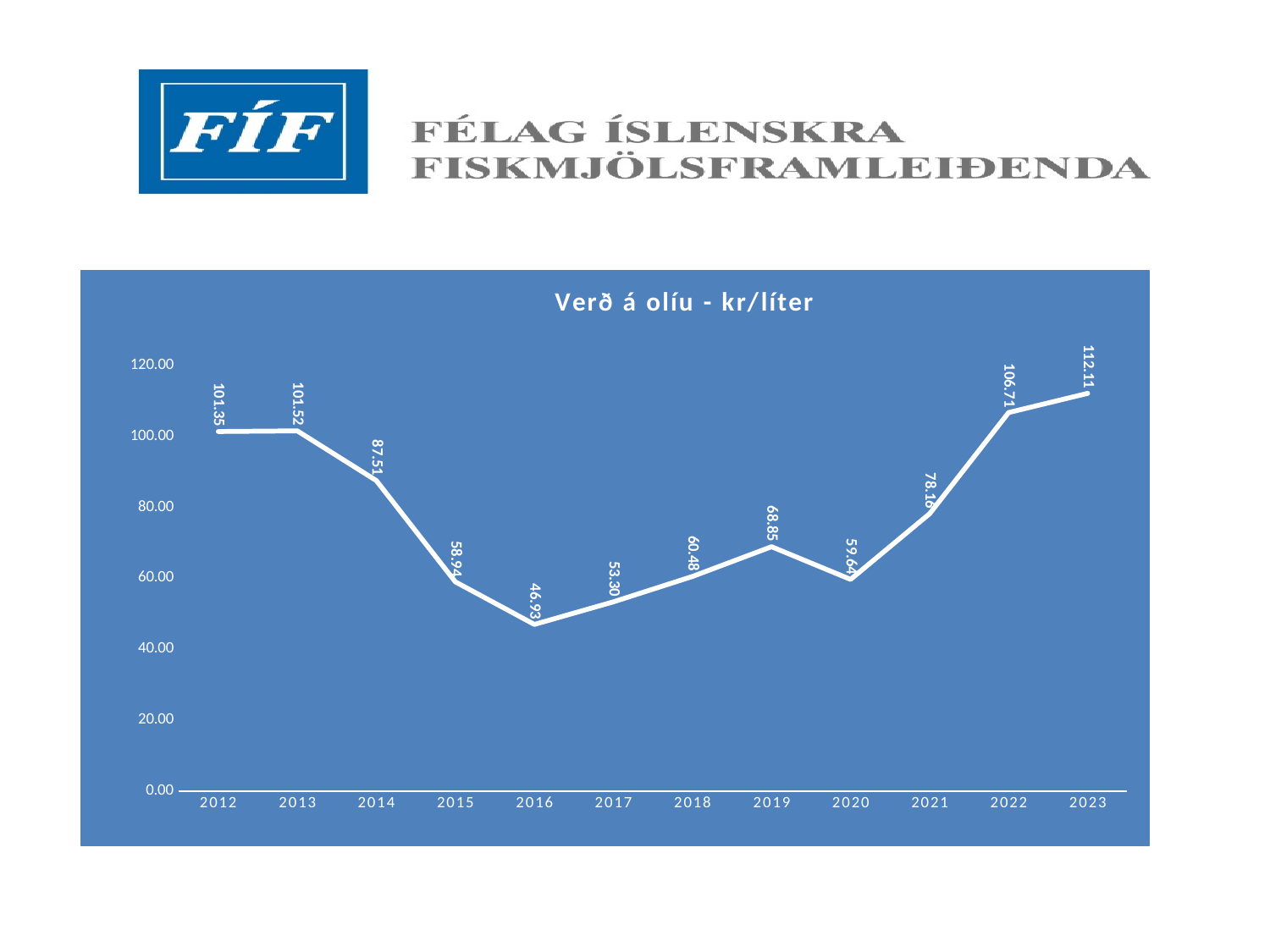
What kind of chart is shown on the slide? line chart What is the difference between the values for 2023 and 2022? 5.40 What is the value for 2023? 112.11 Which year has the lowest value? 2016 What is the title of the chart? Verð á olíu - kr/líter What is the value for 2016? 46.93 What is the value for 2012? 101.35 Which year has the highest value? 2023 How many years are plotted on the x axis? 12 Is the value for 2015 greater or less than 80.00? less Which is larger, the value for 2014 or the value for 2017? 2014 What is the value for 2019? 68.85